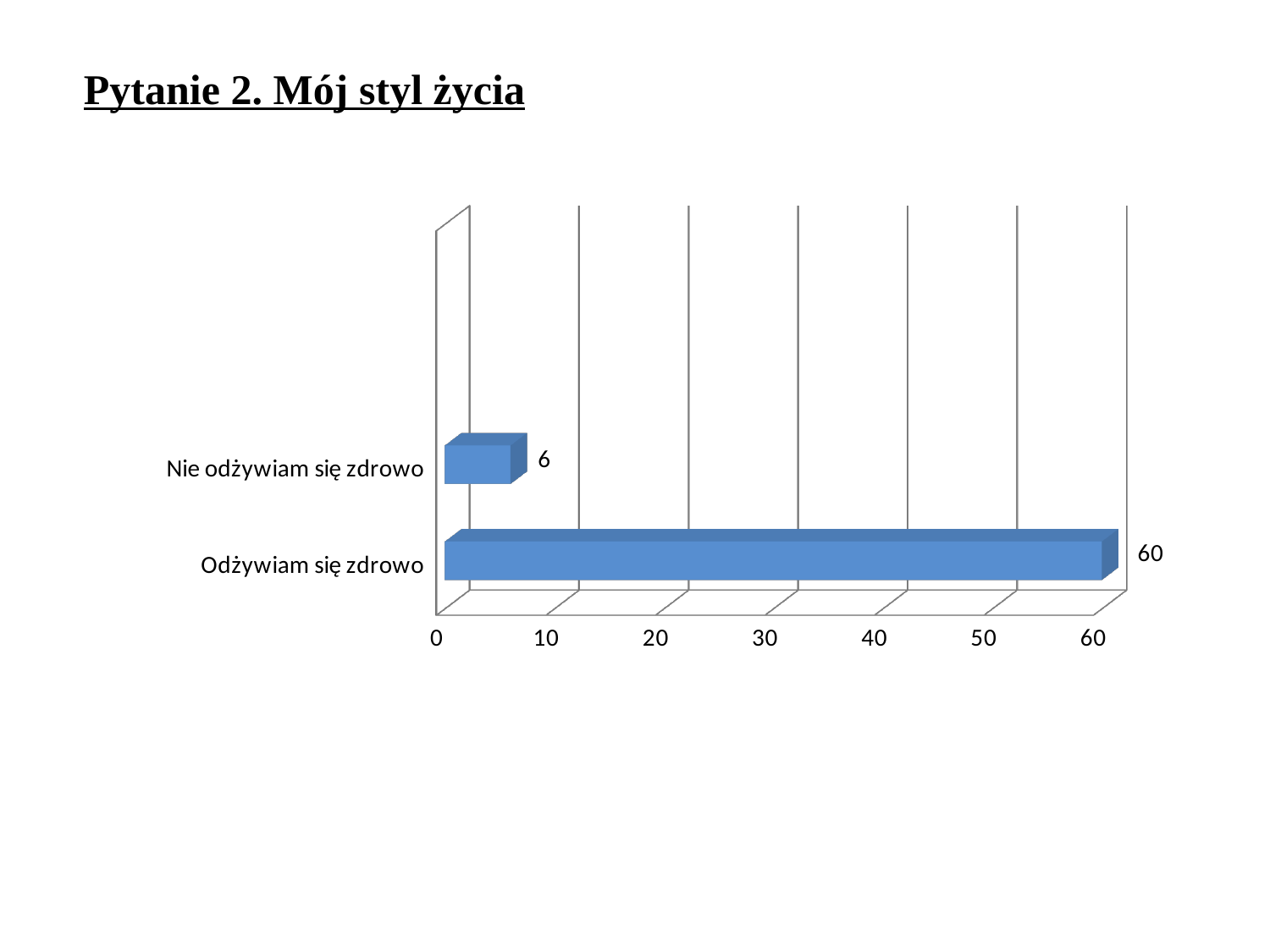
Which category has the highest value? Odżywiam się zdrowo Which category has the lowest value? Nie odżywiam się zdrowo What is the title of the slide? Pytanie 2. Mój styl życia How many categories are shown in the chart? 2 Is the value for "Nie odżywiam się zdrowo" greater or less than 10? less What kind of chart is shown on the slide? bar chart What is the value for "Odżywiam się zdrowo"? 60 What is the difference between the values for "Odżywiam się zdrowo" and "Nie odżywiam się zdrowo"? 54 What is the total of the two values shown in the chart? 66 Which is larger: the value for "Odżywiam się zdrowo" or for "Nie odżywiam się zdrowo"? Odżywiam się zdrowo Is the value for "Odżywiam się zdrowo" greater or less than 50? greater What is the value for "Nie odżywiam się zdrowo"? 6